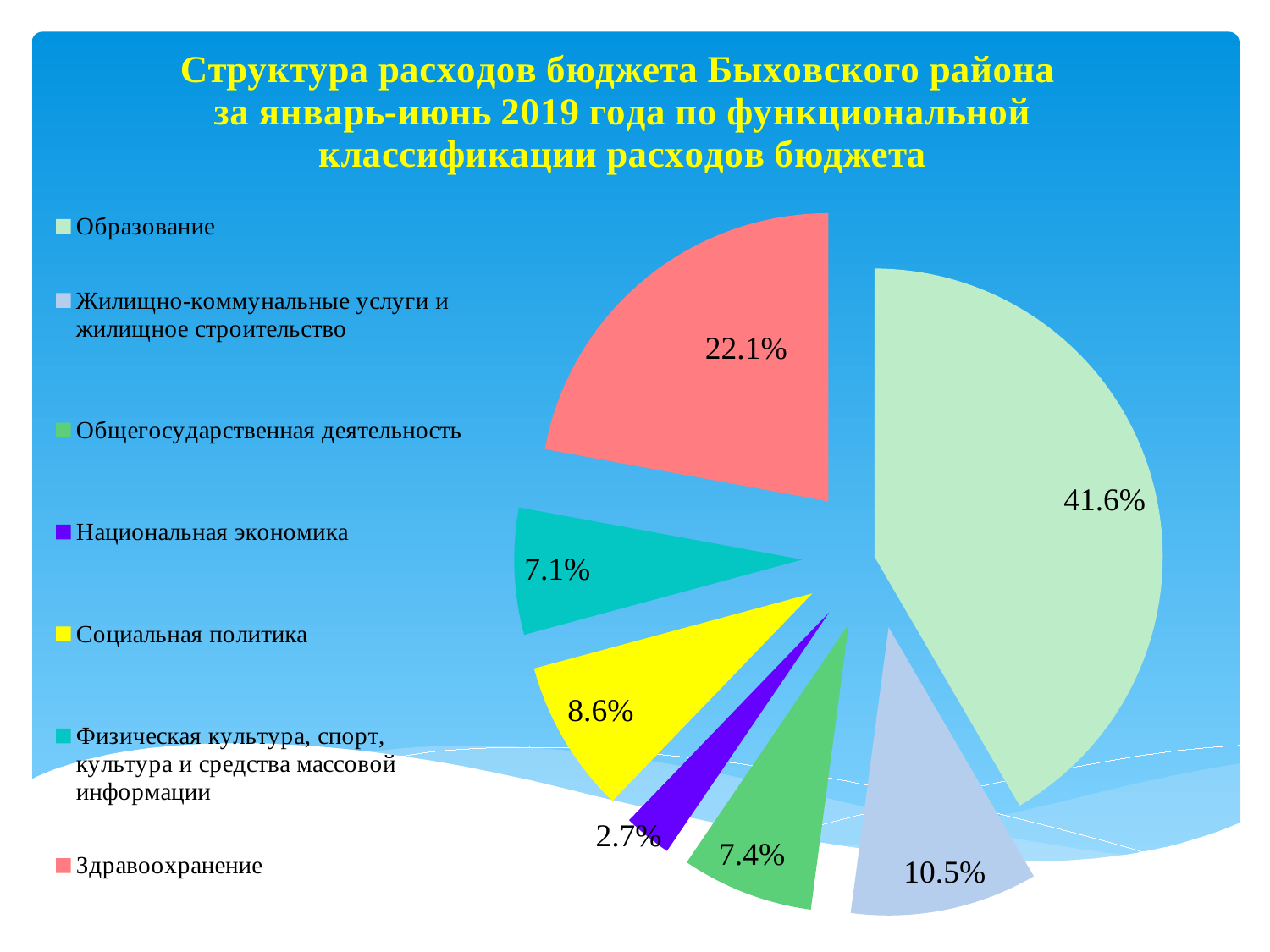
What share of budget expenditure goes to Здравоохранение? 22.1% What share of budget expenditure goes to Национальная экономика? 2.7% What kind of chart is shown on the slide? pie chart What share of budget expenditure goes to Жилищно-коммунальные услуги и жилищное строительство? 10.5% What share of budget expenditure goes to Социальная политика? 8.6% What share of budget expenditure goes to Образование? 41.6% Which is larger: the share of Общегосударственная деятельность or the share of Физическая культура, спорт, культура и средства массовой информации? Общегосударственная деятельность What is the difference between the shares of Образование and Здравоохранение? 19.5% Which category has the largest share of the pie? Образование How many slices does the pie chart have? 7 Which category has the smallest share of the pie? Национальная экономика What colour is the slice for Социальная политика? yellow